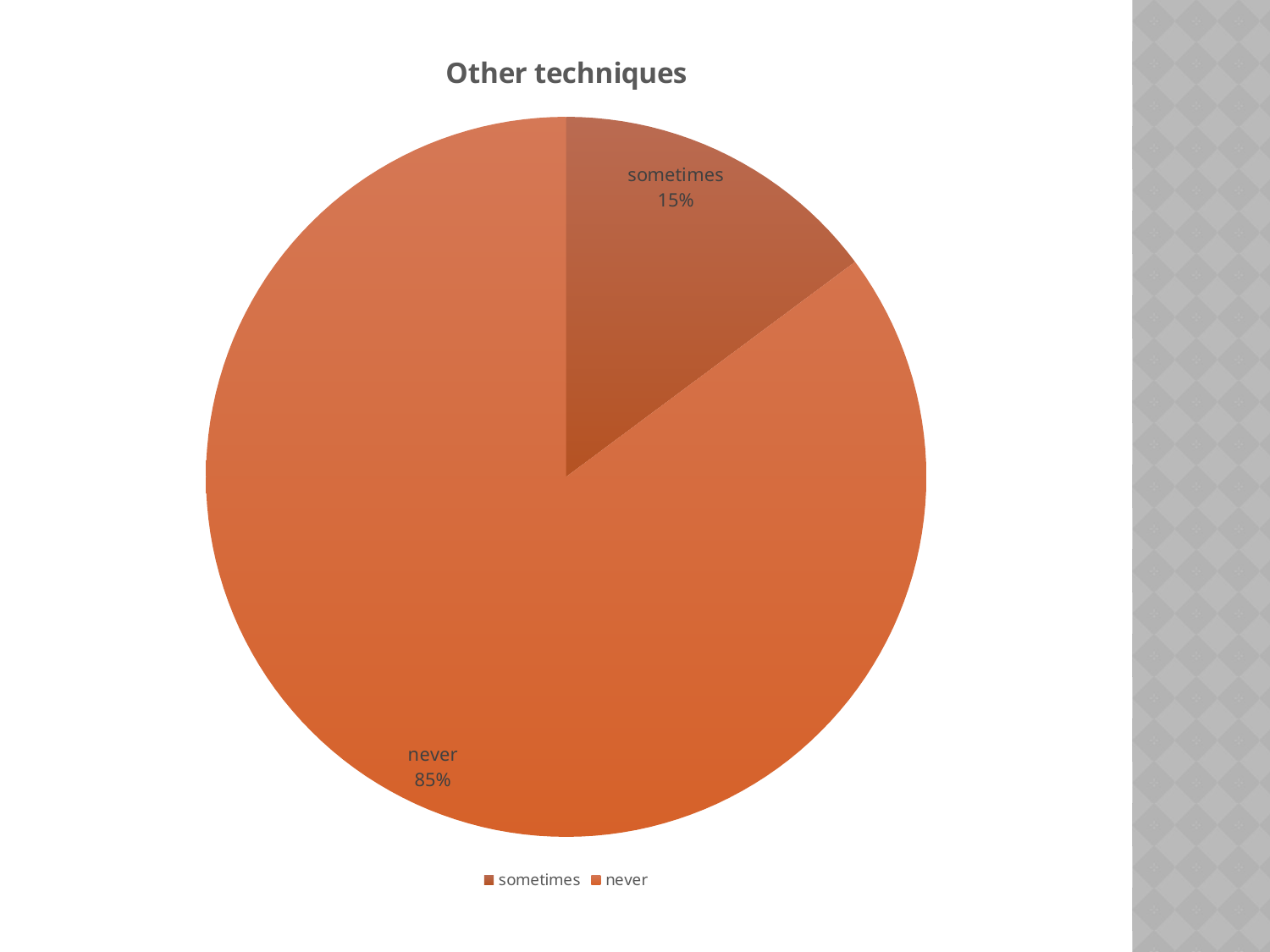
Which category has the smallest slice of the pie? sometimes What kind of chart is shown on the slide? pie chart What share of the pie does the "never" slice represent? 85% What are the two categories listed in the legend? sometimes, never Which category has the largest slice of the pie? never What share of the pie does the "sometimes" slice represent? 15% How many slices does the pie chart have? 2 Which is larger, the "sometimes" slice or the "never" slice? never How many entries does the legend list? 2 What is the difference in percentage points between the "never" and "sometimes" slices? 70 What is the title of the chart? Other techniques